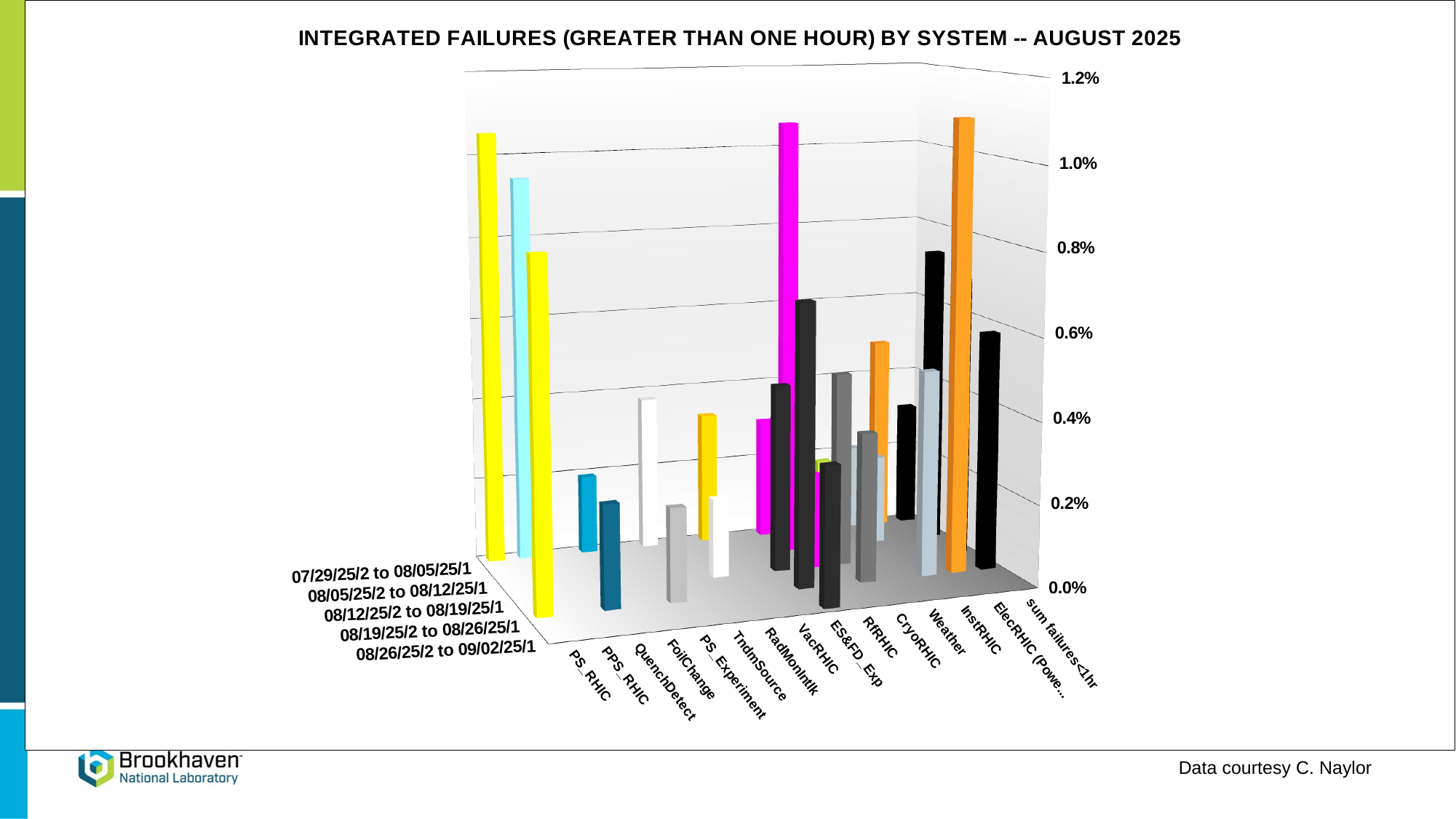
What is the first time period listed on the depth axis of the chart? 07/29/25/2 to 08/05/25/1 How many system categories are listed along the horizontal axis of the chart? 15 What is the first system category listed on the horizontal axis? PS_RHIC What is the lowest value shown on the vertical axis of the chart? 0.0% What is the title of the chart? INTEGRATED FAILURES (GREATER THAN ONE HOUR) BY SYSTEM -- AUGUST 2025 What kind of chart is shown on the slide? bar chart Which system category appears immediately after VacRHIC on the horizontal axis? ES&FD_Exp How many weekly time periods are listed along the depth axis of the chart? 5 What is the highest value shown on the vertical axis of the chart? 1.2% What is the last time period listed on the depth axis of the chart? 08/26/25/2 to 09/02/25/1